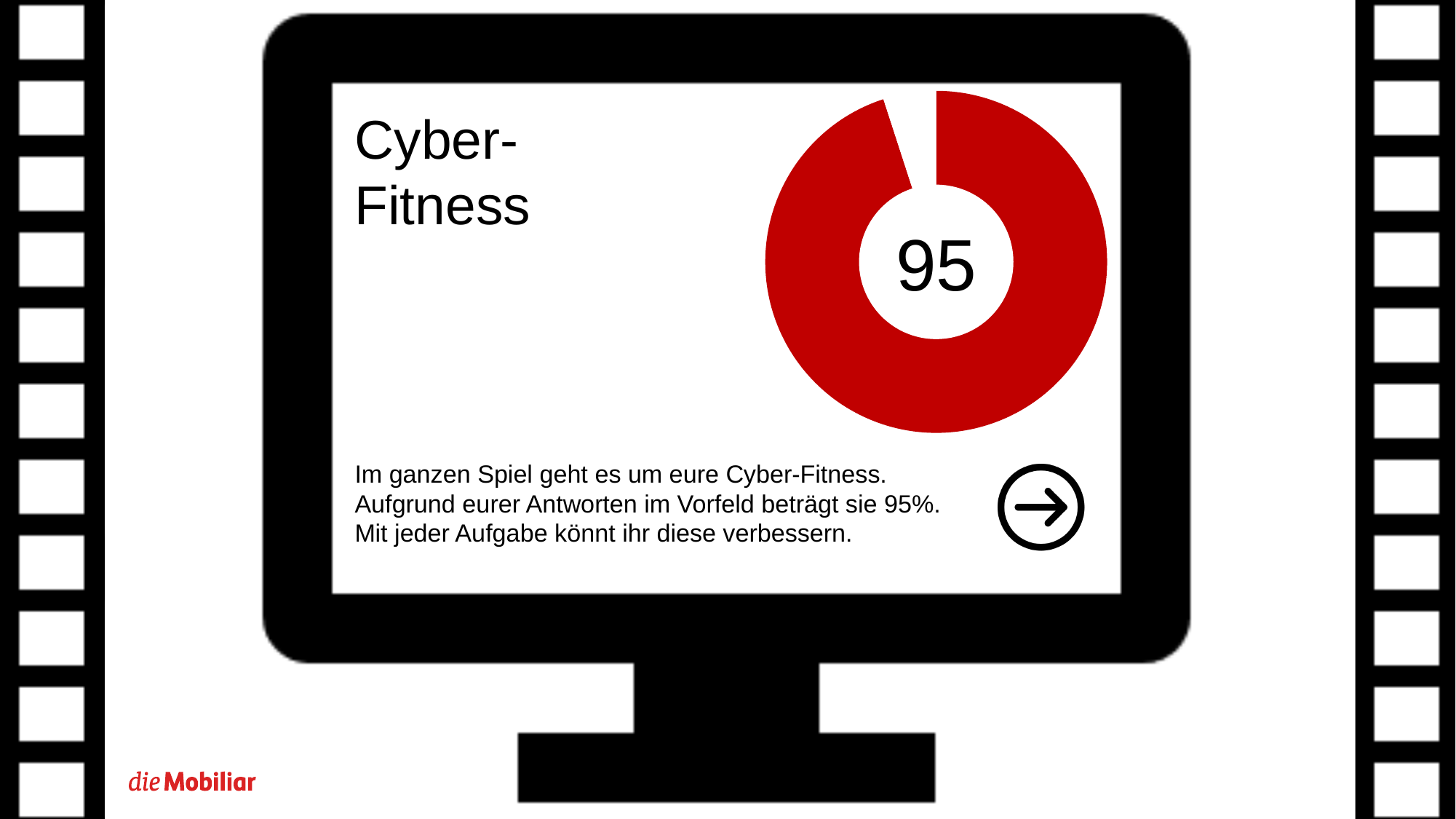
What share of the doughnut chart is filled in red? 95% What is the title shown next to the doughnut chart? Cyber-Fitness Is the value shown in the doughnut chart greater or less than 50? greater Which is larger in the doughnut chart, the red filled portion or the white unfilled portion? The red filled portion How many segments does the doughnut chart have? 2 What colour is the filled portion of the doughnut chart? Red What kind of chart is shown on the slide? Doughnut chart What share of the doughnut chart is left unfilled (white)? 5% What number is printed in the centre of the doughnut chart? 95